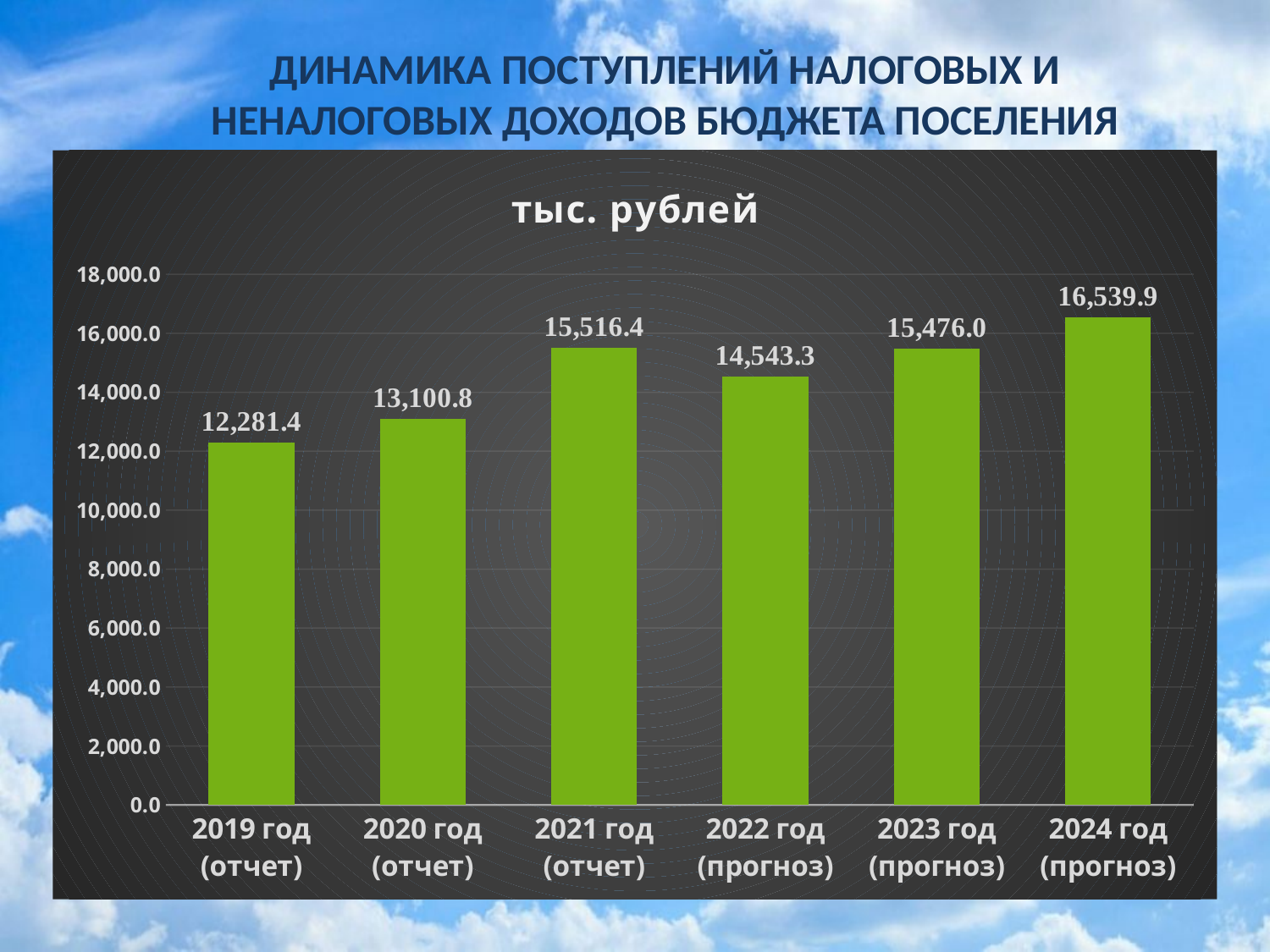
What is the value for 2024 год (прогноз)? 16,539.9 What is the title shown above the chart's plot area? тыс. рублей Is the value for 2020 год (отчет) greater or less than 14,000.0? less What kind of chart is shown on the slide? bar chart What is the difference between the values for 2021 год (отчет) and 2022 год (прогноз)? 973.1 Which year has the lowest value? 2019 год (отчет) What is the difference between the values for 2024 год (прогноз) and 2019 год (отчет)? 4,258.5 Which is larger, the value for 2021 год (отчет) or 2023 год (прогноз)? 2021 год (отчет) How many years are shown on the chart? 6 What is the value for 2019 год (отчет)? 12,281.4 Which year has the highest value? 2024 год (прогноз) What is the value for 2022 год (прогноз)? 14,543.3